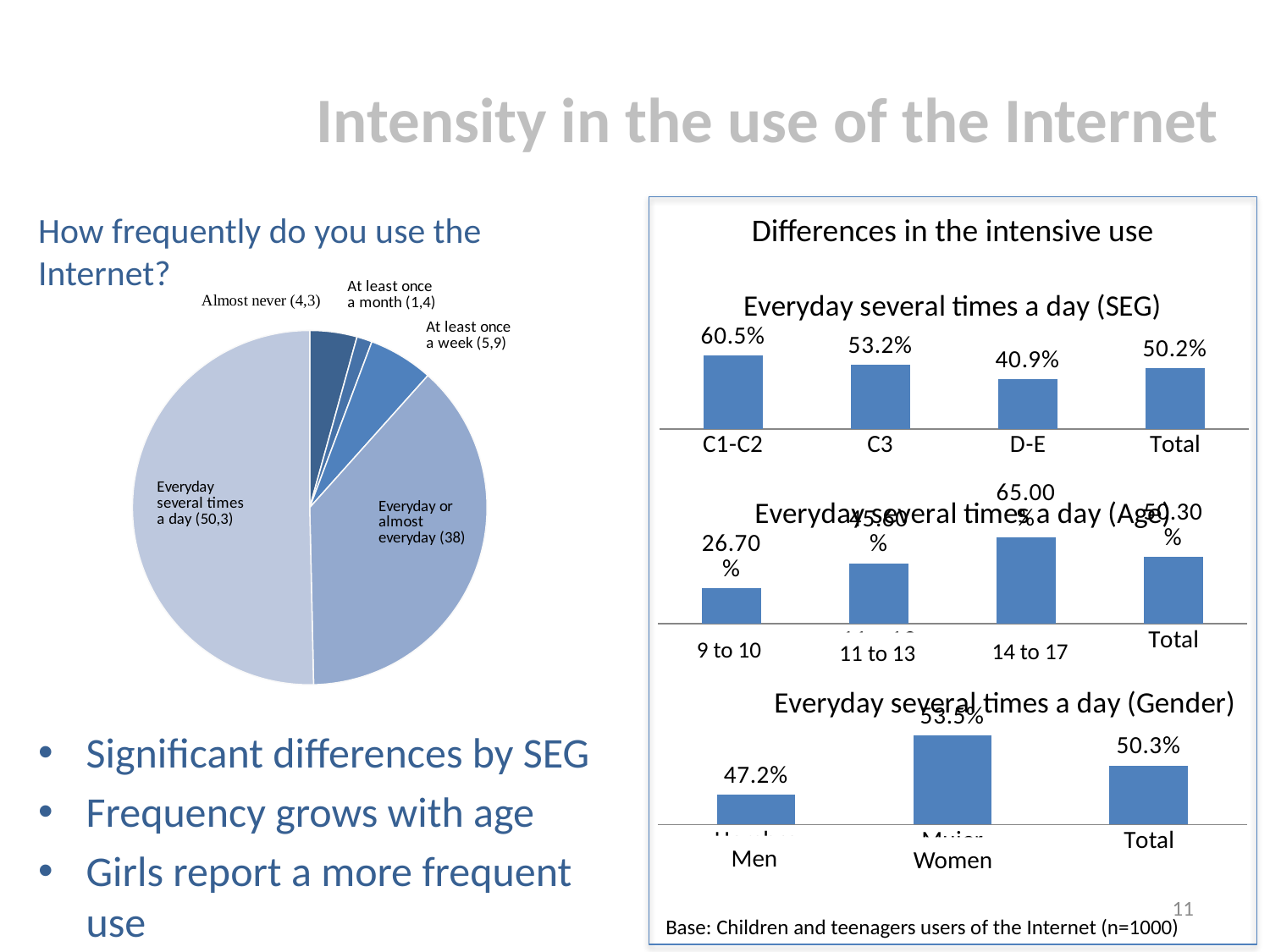
In the pie chart 'How frequently do you use the Internet?', what is the value for 'Almost never'? 4,3 In the pie chart 'How frequently do you use the Internet?', which category has the smallest slice? At least once a month In the 'Everyday several times a day (SEG)' chart, what is the difference between C1-C2 and D-E? 19.6% In the 'Everyday several times a day (Gender)' chart, which is larger, Men or Women? Women In the 'Everyday several times a day (SEG)' chart, which category has the lowest value? D-E In the pie chart 'How frequently do you use the Internet?', how many slices are there? 5 In the pie chart 'How frequently do you use the Internet?', what is the value for 'Everyday several times a day'? 50,3 In the 'Everyday several times a day (Age)' chart, do the values rise or fall from 9 to 10 through 14 to 17? rise What kind of chart is 'Everyday several times a day (Gender)'? bar chart In the 'Everyday several times a day (Age)' chart, which age group has the highest value? 14 to 17 In the 'Everyday several times a day (Age)' chart, what is the value for 9 to 10? 26.70% In the 'Everyday several times a day (SEG)' chart, what is the value for C1-C2? 60.5%